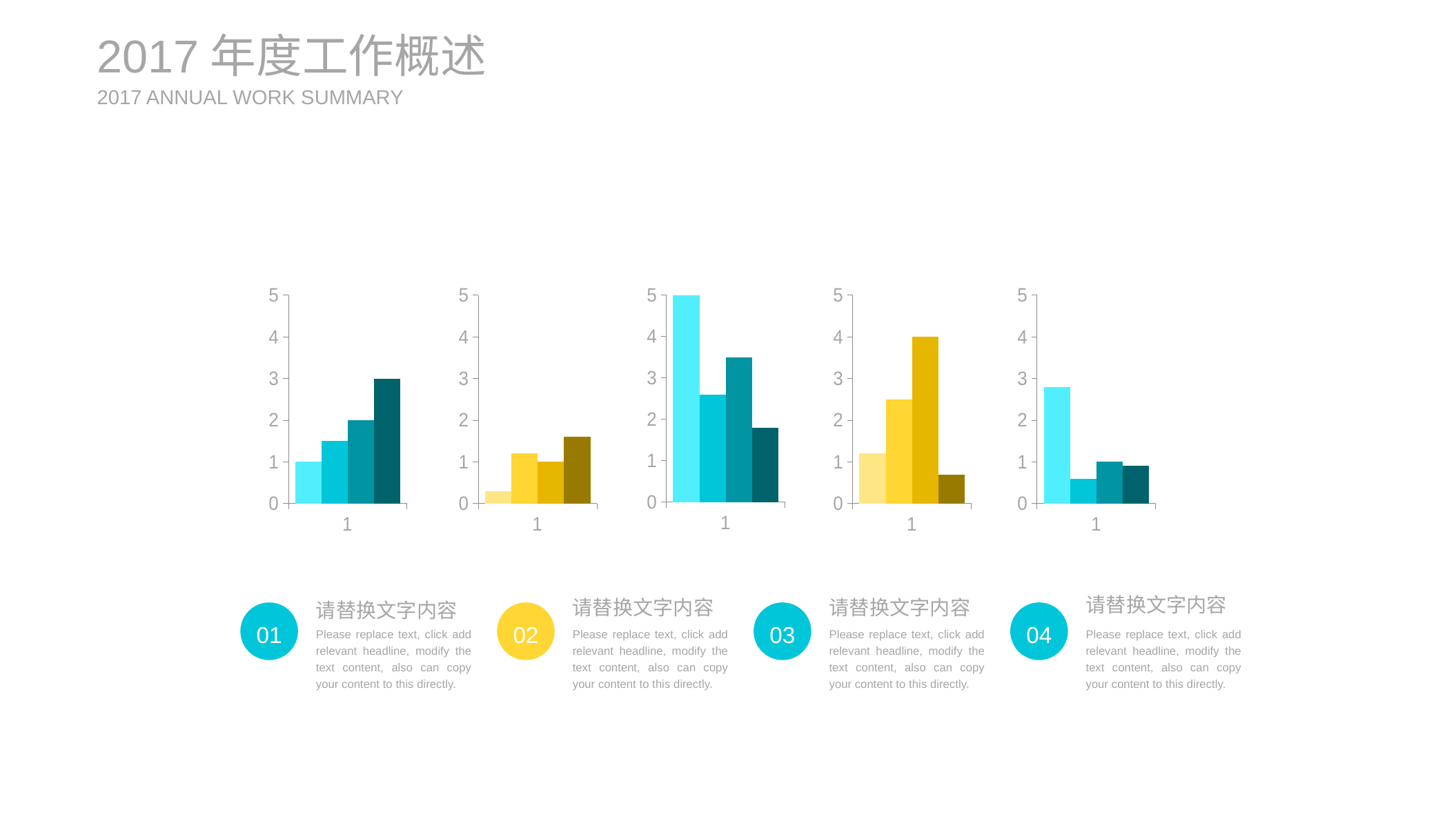
In the fourth chart from the left, what value does the tallest bar reach? 4 In the middle chart, is the value of the second bar greater or less than 2? greater How many category labels appear on the x axis of the second chart from the left? 1 What kind of chart is the leftmost chart on the slide? bar chart In the leftmost chart, what value does the first (lightest) bar reach? 1 How many bars does the leftmost chart show? 4 In the leftmost chart, do the bars rise or fall from left to right? rise In the middle chart, what value does the tallest bar reach? 5 In the middle chart, which bar is the tallest: the first, second, third or fourth? first In the fourth chart from the left, which bar is the shortest: the first, second, third or fourth? fourth In the rightmost chart, is the value of the first bar greater or less than 2? greater In the leftmost chart, what value does the tallest (darkest) bar reach? 3